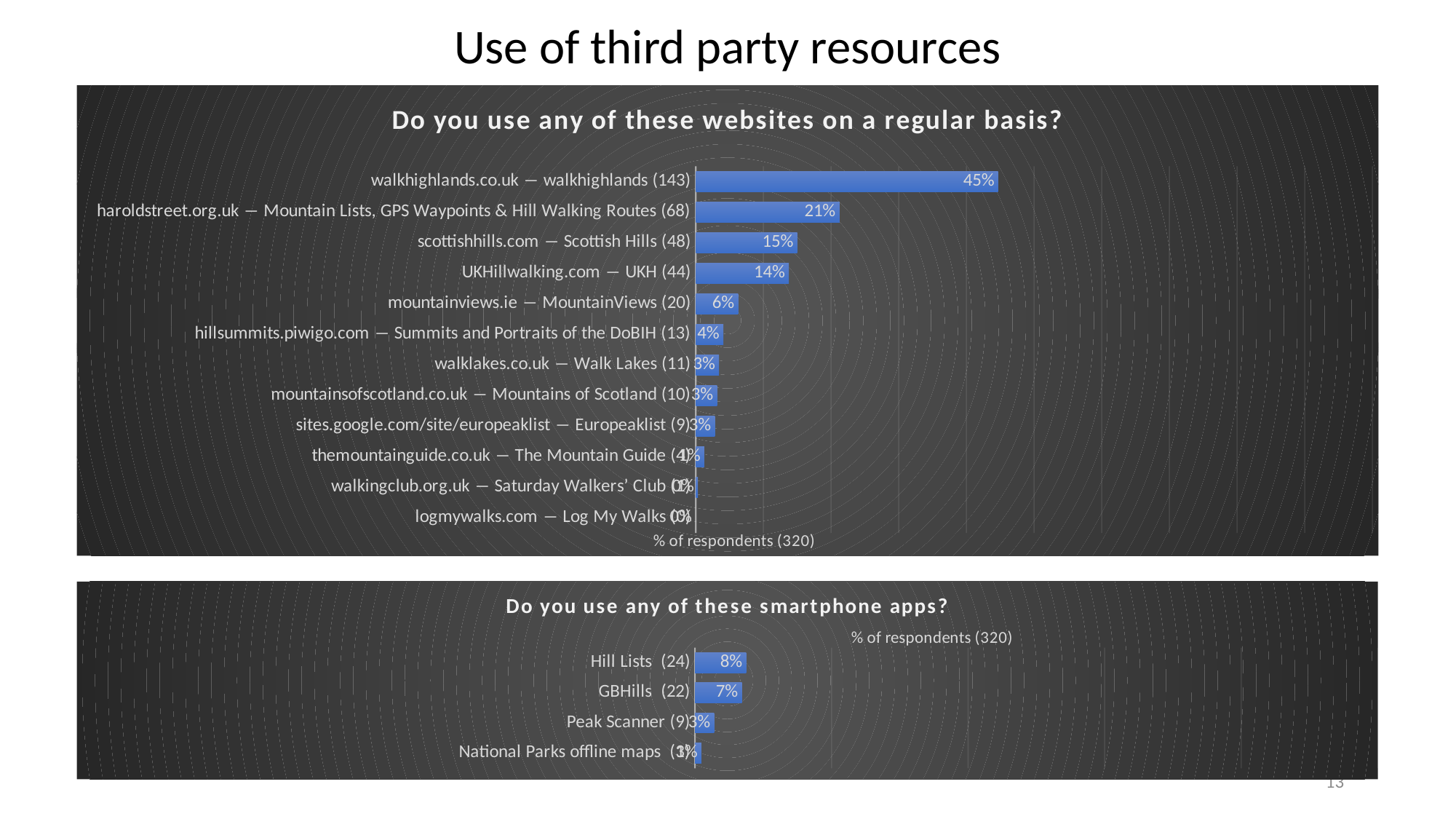
How many apps are listed in the chart 'Do you use any of these smartphone apps?'? 4 How many websites are listed in the chart 'Do you use any of these websites on a regular basis?'? 12 In the chart 'Do you use any of these websites on a regular basis?', which website has the highest percentage? walkhighlands.co.uk In the chart 'Do you use any of these websites on a regular basis?', what percentage of respondents use walkhighlands.co.uk? 45% In the chart 'Do you use any of these smartphone apps?', what is the difference between Hill Lists and Peak Scanner? 5% In the chart 'Do you use any of these smartphone apps?', what is the value for Hill Lists? 8% In the chart 'Do you use any of these websites on a regular basis?', what is the difference between walkhighlands.co.uk and haroldstreet.org.uk? 24% In the chart 'Do you use any of these websites on a regular basis?', what is the value for UKHillwalking.com? 14% In the chart 'Do you use any of these websites on a regular basis?', what is the value for haroldstreet.org.uk? 21% In the chart 'Do you use any of these smartphone apps?', what is the value for GBHills? 7% What kind of chart is 'Do you use any of these websites on a regular basis?'? Bar chart In the chart 'Do you use any of these websites on a regular basis?', which is larger, scottishhills.com or mountainviews.ie? scottishhills.com